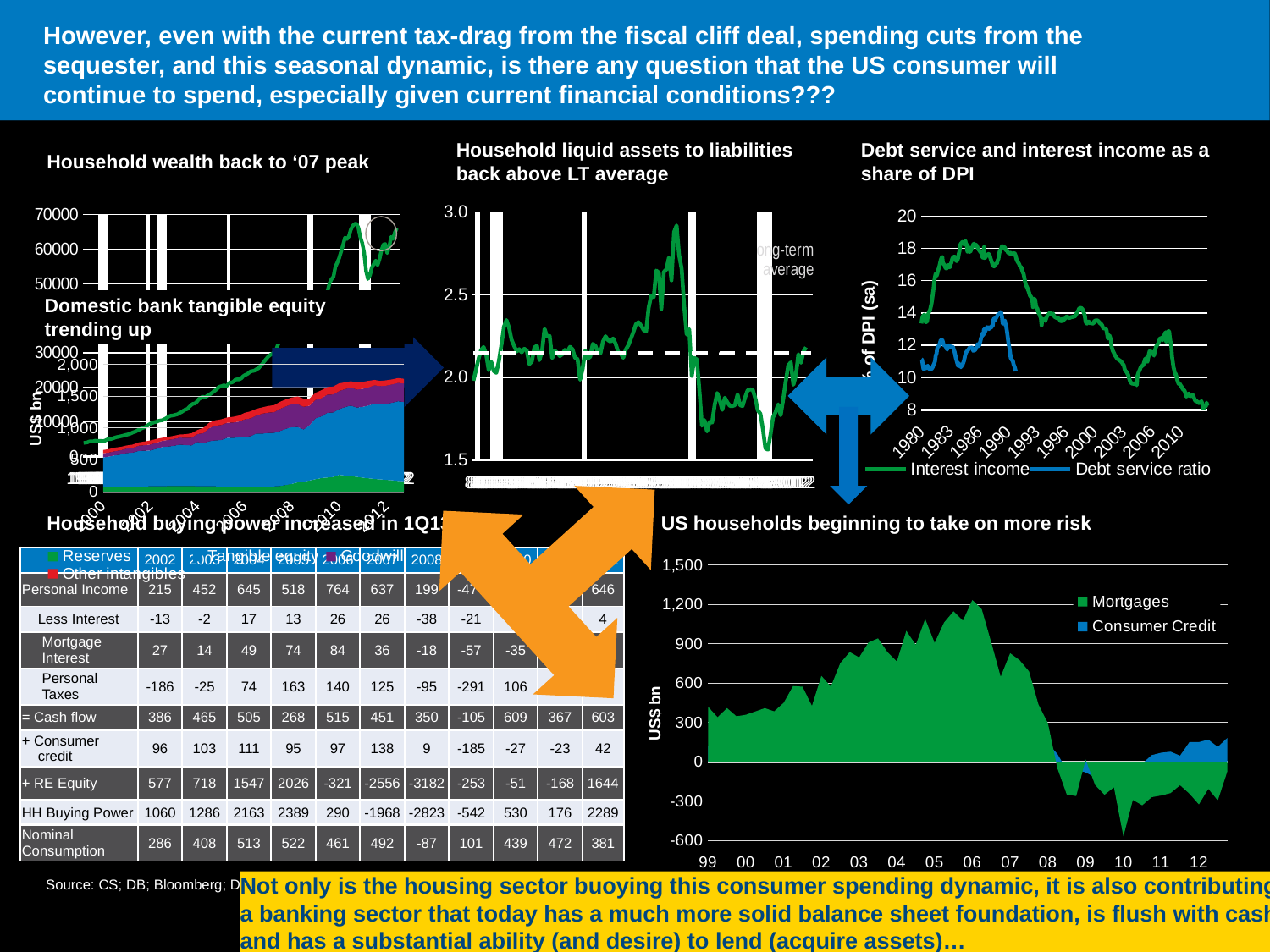
How many series does the legend of 'Debt service and interest income as a share of DPI' list? 2 In 'Household liquid assets to liabilities back above LT average', is the lowest value around 2009 greater or less than 2.0? less In 'Debt service and interest income as a share of DPI', does the Interest income line rise or fall between 2006 and 2010? fall In 'Debt service and interest income as a share of DPI', is the peak of the Interest income line greater or less than 16? greater In 'US households beginning to take on more risk', which series is shown in green? Mortgages In 'US households beginning to take on more risk', is the Mortgages value in 2009 greater or less than 0? less What are the two legend entries in 'Debt service and interest income as a share of DPI'? Interest income; Debt service ratio What kind of chart is 'US households beginning to take on more risk'? Stacked area chart How many series does the legend of 'Domestic bank tangible equity trending up' list? 4 How many series does the legend of 'US households beginning to take on more risk' list? 2